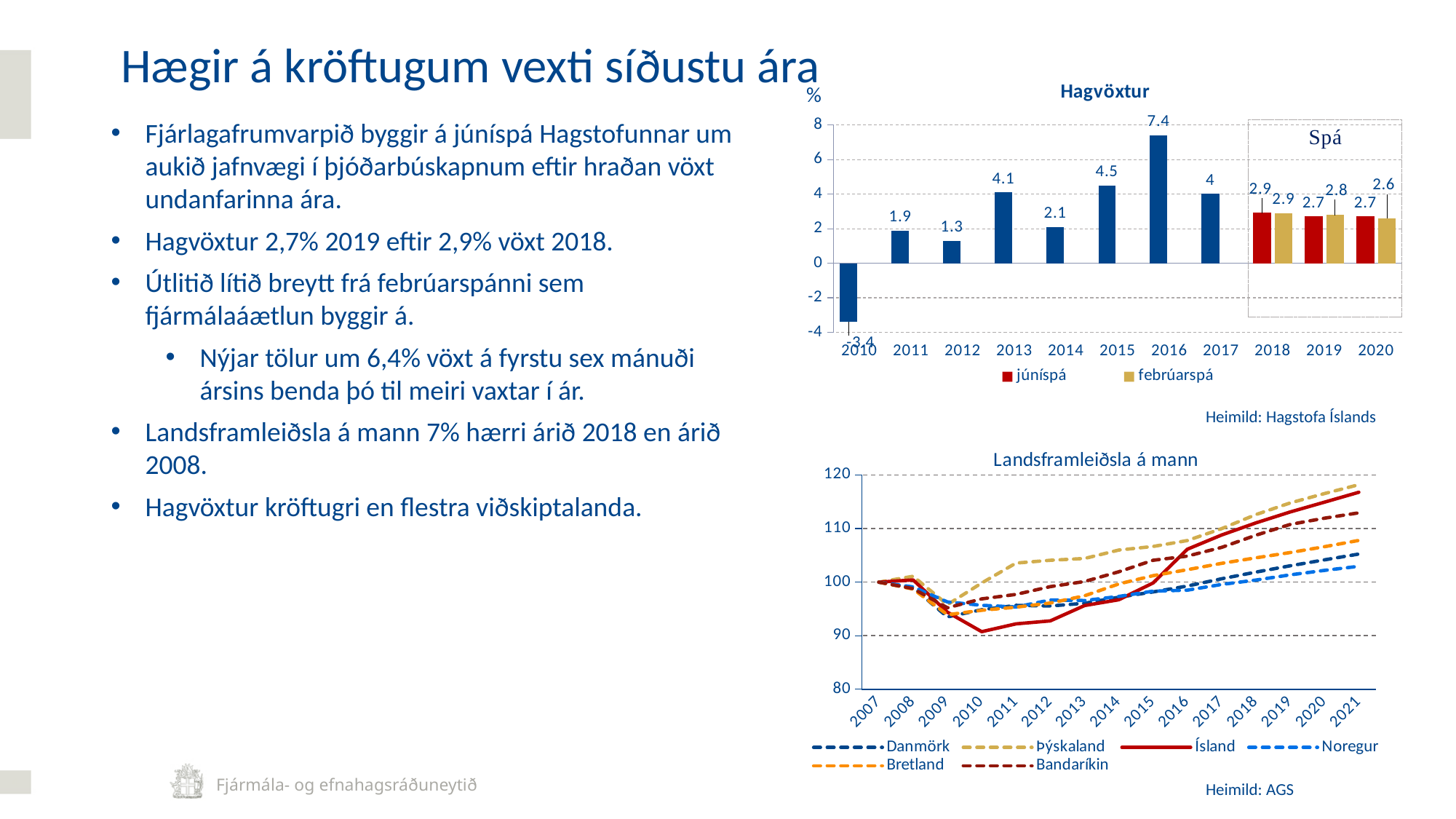
In the Landsframleiðsla á mann chart, how many series does the legend list? 6 In the Hagvöxtur chart, what is the value for 2010? -3.4 In the Hagvöxtur chart, how many series does the legend list? 2 In the Landsframleiðsla á mann chart, is the value for Ísland in 2010 greater or less than 100? less In the Hagvöxtur chart, what is the value for 2016? 7.4 In the Hagvöxtur chart, which year has the lowest value? 2010 In the Hagvöxtur chart, which is larger, the value for 2013 or the value for 2014? 2013 What kind of chart is the Landsframleiðsla á mann chart? line chart In the Hagvöxtur chart, what is the difference between the 2016 value and the 2017 value? 3.4 In the Hagvöxtur chart, which year has the highest growth? 2016 In the Hagvöxtur chart, what is the febrúarspá value for 2020? 2.6 In the Hagvöxtur chart, what is the júníspá value for 2019? 2.7